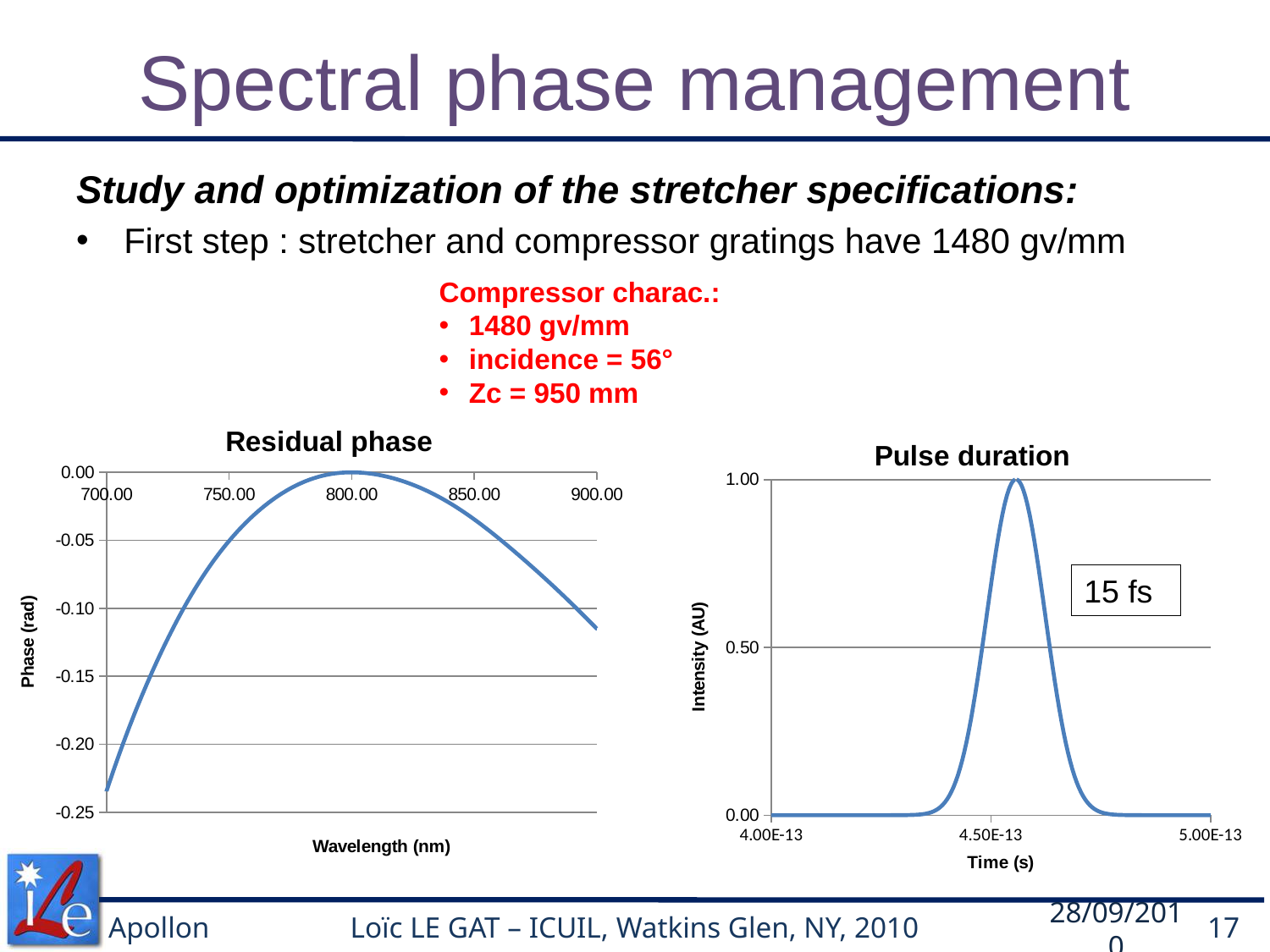
In the Residual phase chart, does the phase rise or fall between 700.00 nm and 800.00 nm? rise What kind of chart is the Pulse duration chart? line chart In the Residual phase chart, is the phase at 700.00 nm greater or less than -0.20? less In the Pulse duration chart, what is the peak intensity of the curve? 1.00 In the Residual phase chart, at which wavelength does the phase reach its maximum? 800.00 In the Residual phase chart, what is the label of the x axis? Wavelength (nm) In the Residual phase chart, what is the maximum phase value reached by the curve? 0.00 What kind of chart is the Residual phase chart? line chart In the Pulse duration chart, is the intensity at 4.00E-13 s greater or less than 0.50? less In the Pulse duration chart, what is the label of the y axis? Intensity (AU) In the Residual phase chart, does the phase rise or fall between 800.00 nm and 900.00 nm? fall In the Residual phase chart, is the phase at 900.00 nm greater or less than -0.15? greater